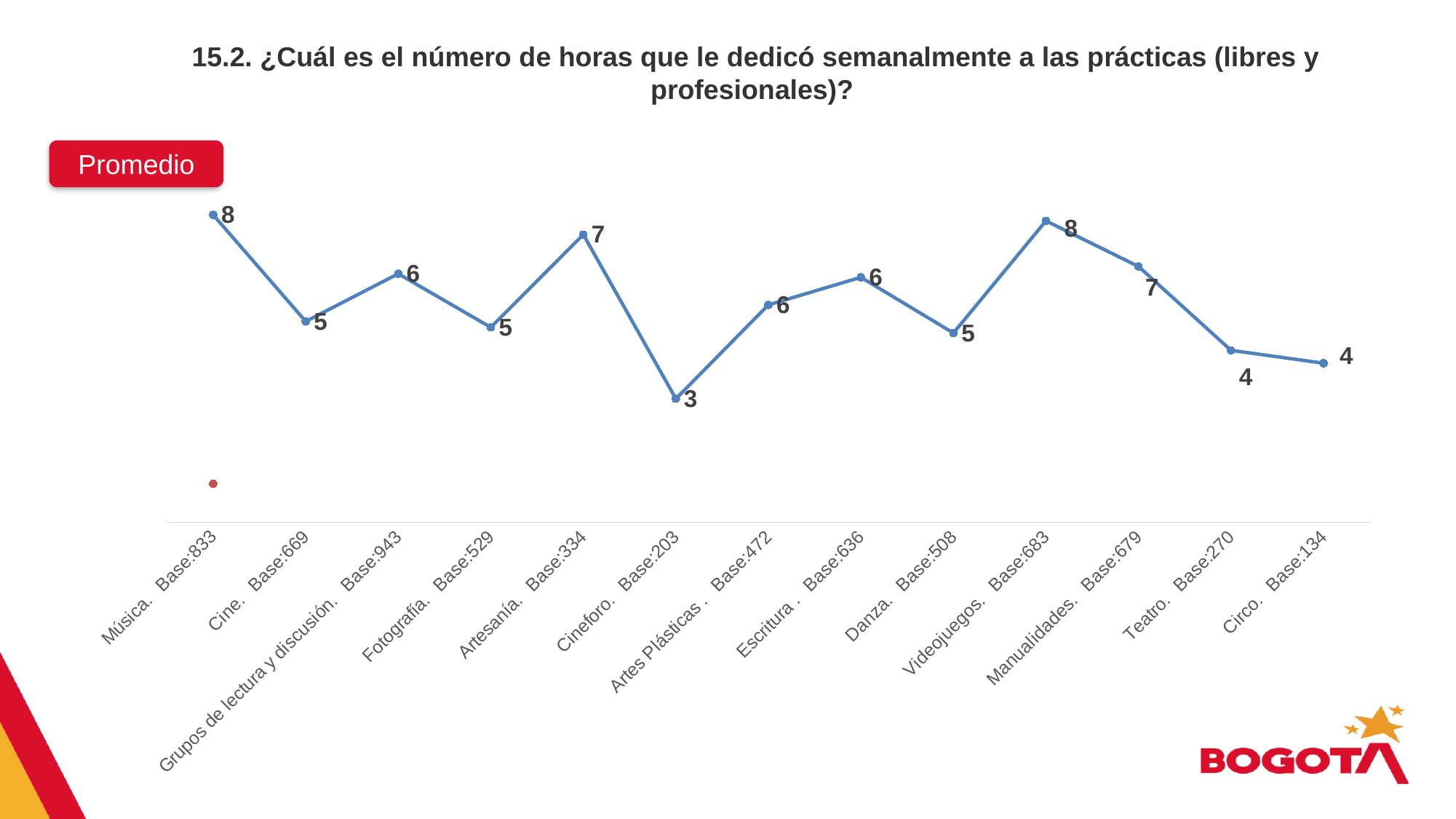
What label appears in the red box above the chart? Promedio What is the value shown for Circo (Base:134)? 4 Which has a higher value, Manualidades (Base:679) or Danza (Base:508)? Manualidades. Base:679 What is the value shown for Cineforo (Base:203)? 3 Which category has the lowest value on the chart? Cineforo. Base:203 What kind of chart is shown on the slide? Line chart What is the average number of weekly hours for Música (Base:833)? 8 What is the difference between the values for Videojuegos (Base:683) and Teatro (Base:270)? 4 Which has a higher value, Cine (Base:669) or Grupos de lectura y discusión (Base:943)? Grupos de lectura y discusión. Base:943 How many categories are plotted on the chart? 13 What is the value shown for Artesanía (Base:334)? 7 What is the difference between the values for Artesanía (Base:334) and Cineforo (Base:203)? 4